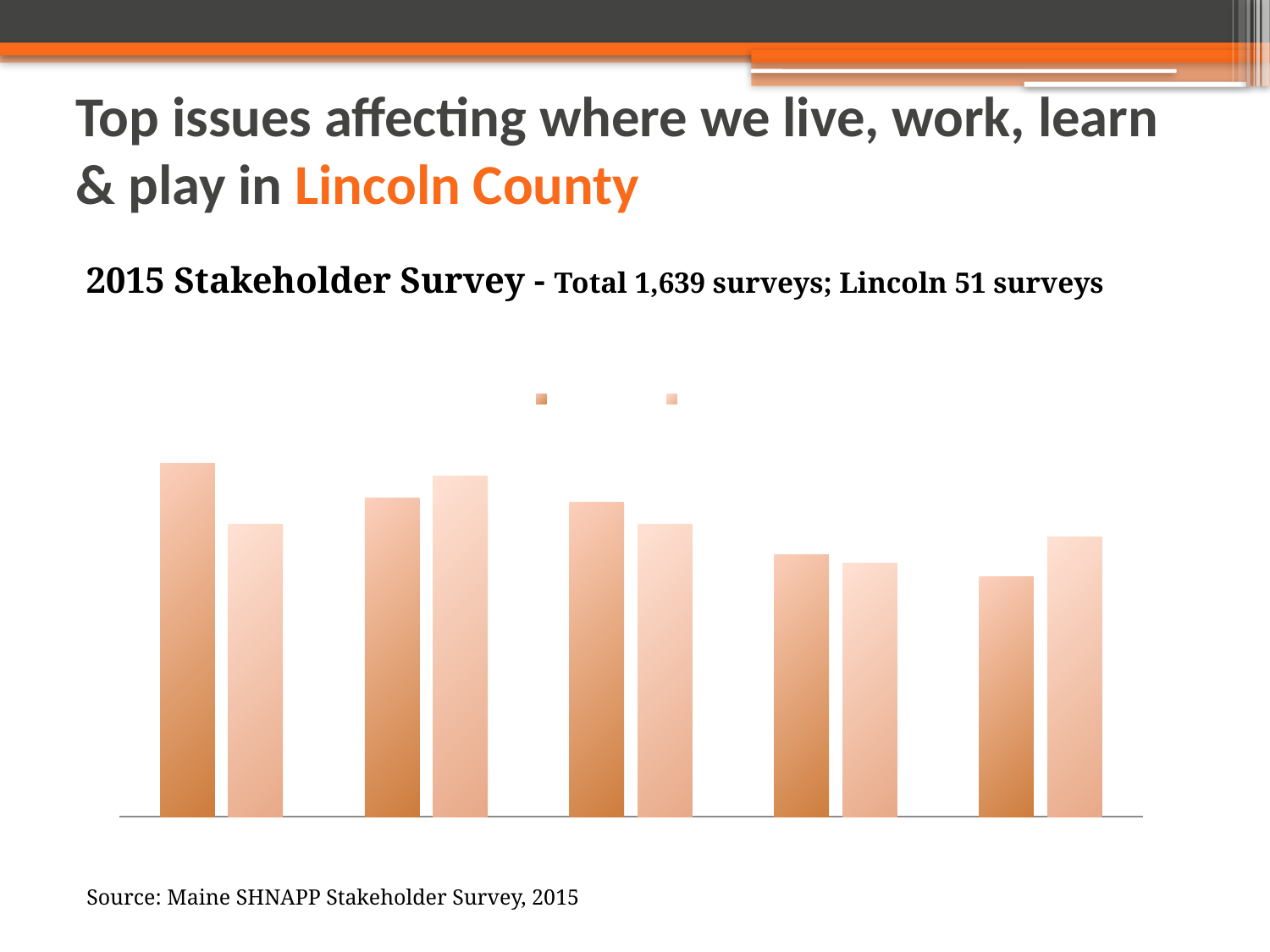
How many series does the chart's legend list? 2 What kind of chart is shown on the slide? bar chart What colour scheme is used for the bars in the chart? shades of orange How many groups of bars does the chart show? 5 In the first (leftmost) group of bars, which is taller: the darker bar or the lighter bar? the darker bar Which group of bars, by position from the left, contains the shortest darker-orange bar? the fifth group Which group of bars, by position from the left, contains the tallest darker-orange bar? the first group In the second group of bars from the left, which is taller: the darker bar or the lighter bar? the lighter bar Do the values of the darker-orange series rise or fall from left to right along the x axis? fall In the last (rightmost) group of bars, which is taller: the darker bar or the lighter bar? the lighter bar